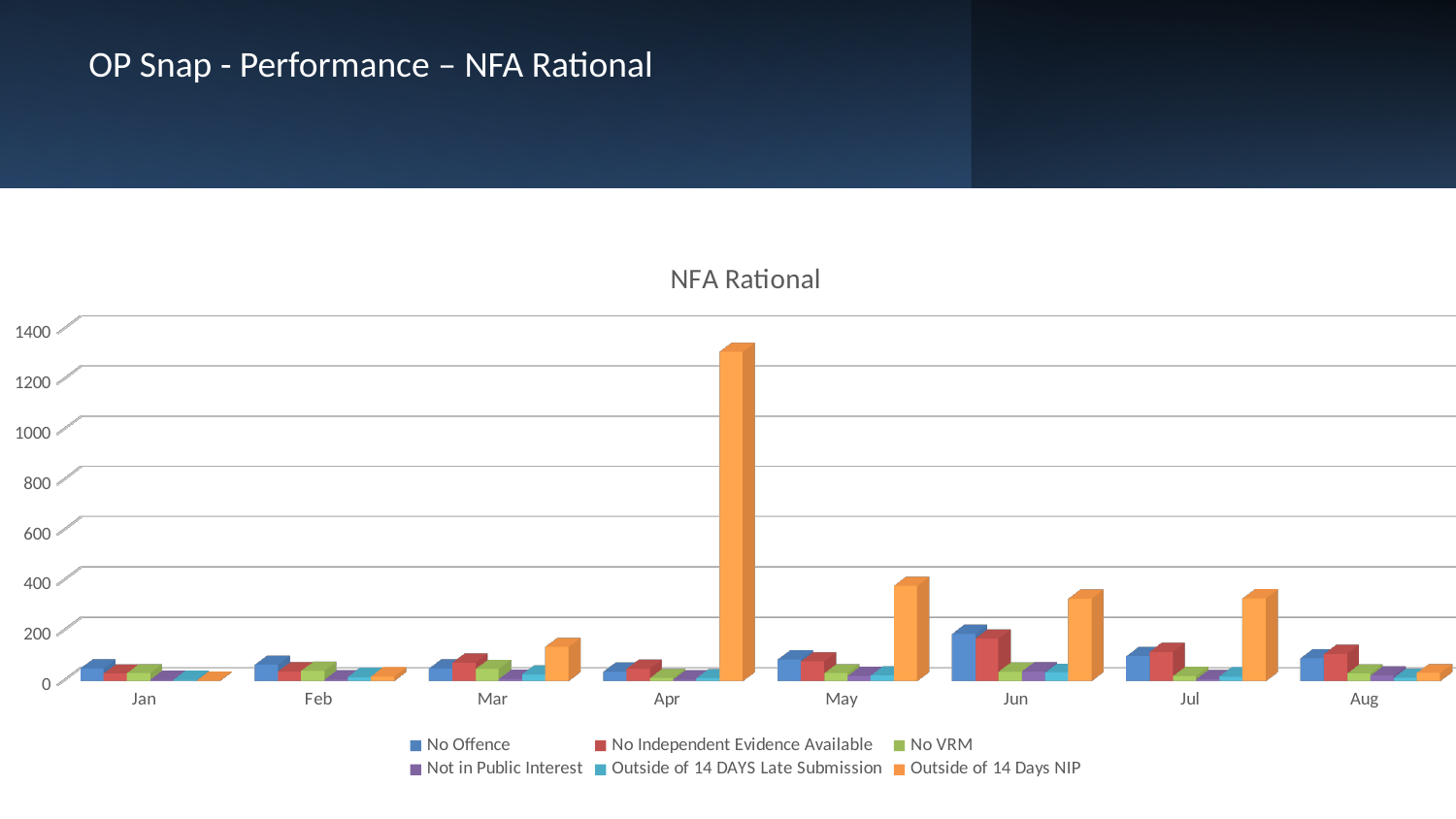
What kind of chart is shown on the slide? bar chart Is the value for Outside of 14 Days NIP in Apr greater or less than 1200? greater Which is larger: Outside of 14 Days NIP in Apr or Outside of 14 Days NIP in May? Apr How many series does the chart's legend list? 6 How many months are shown on the x axis of the chart? 8 Which is larger: No Offence in Jun or No Offence in Jan? Jun Which month has the highest value for Outside of 14 Days NIP? Apr Is the value for Outside of 14 Days NIP in Mar greater or less than 200? less What is the title of the chart? NFA Rational Is the value for Outside of 14 Days NIP in Jun greater or less than 400? less Which month has the highest value for No Offence? Jun Which colour represents Outside of 14 Days NIP in the chart? orange